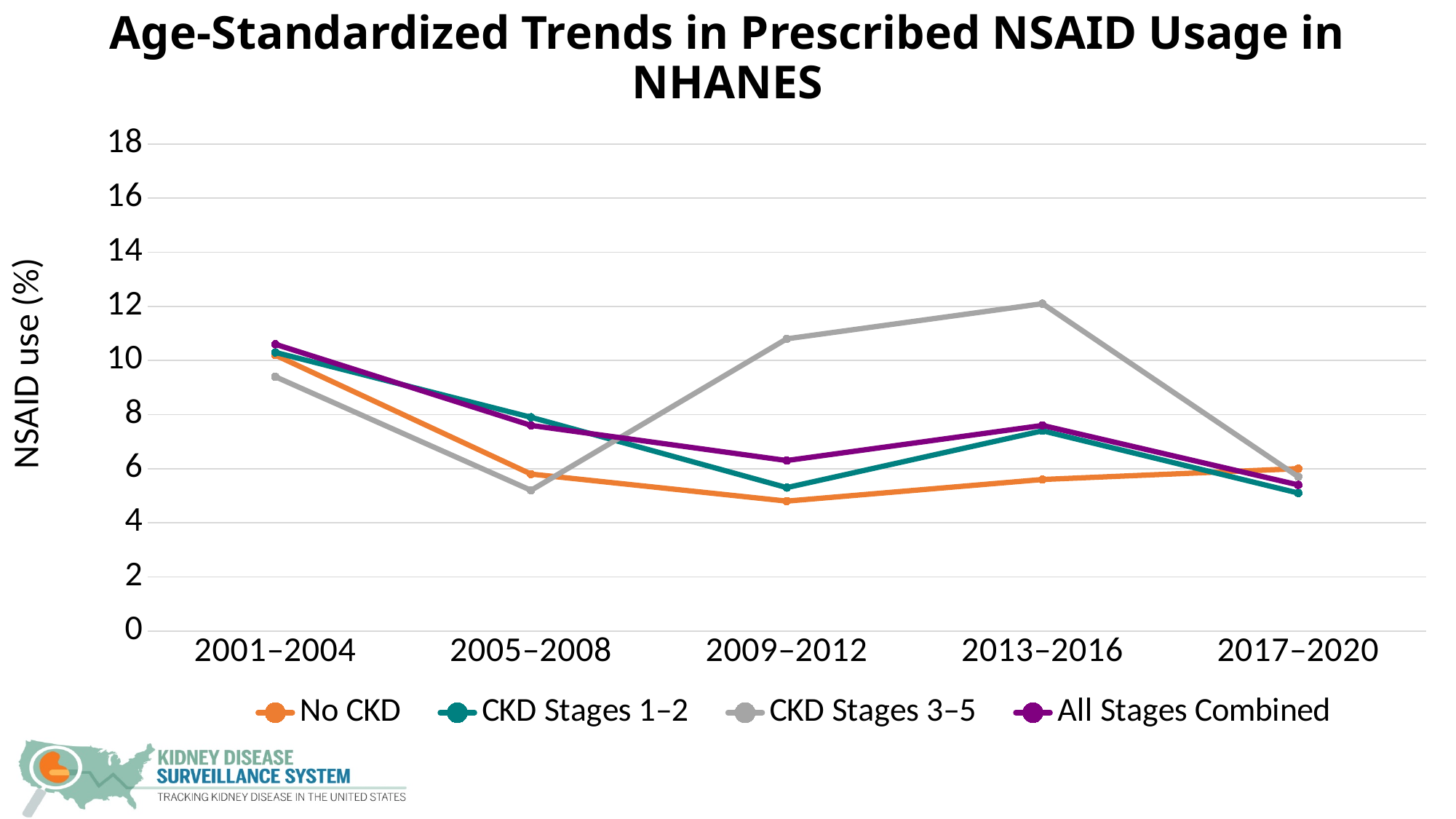
Does the No CKD line rise or fall from 2001–2004 to 2009–2012? Falls Is the value for No CKD in 2009–2012 greater or less than 6? less In 2009–2012, which is larger: the value for CKD Stages 3–5 or the value for No CKD? CKD Stages 3–5 How many series does the legend list? 4 How many survey periods are shown along the x axis? 5 What colour is the line for CKD Stages 3–5? Grey What kind of chart is shown on the slide? Line chart In which survey period is the No CKD line at its lowest? 2009–2012 Is the value for CKD Stages 3–5 in 2013–2016 greater or less than 10? greater In which survey period does the CKD Stages 3–5 line reach its highest value? 2013–2016 What is the label on the y axis? NSAID use (%) Which series has the highest value in 2009–2012? CKD Stages 3–5